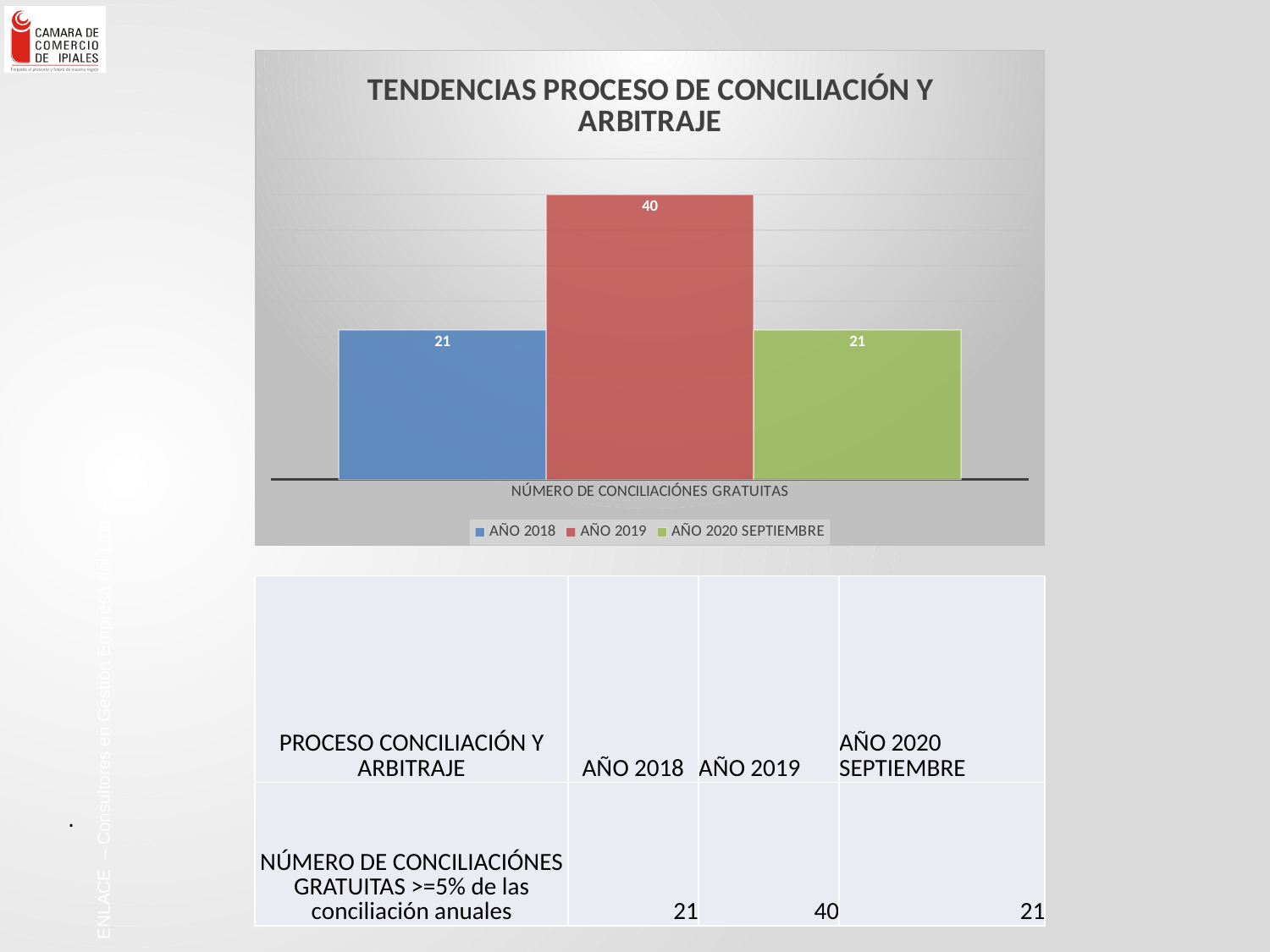
Which is larger, the value for AÑO 2019 or the value for AÑO 2020 SEPTIEMBRE? AÑO 2019 What is the title of the chart? TENDENCIAS PROCESO DE CONCILIACIÓN Y ARBITRAJE What is the category label shown on the x axis of the chart? NÚMERO DE CONCILIACIÓNES GRATUITAS Do the values for AÑO 2018 and AÑO 2020 SEPTIEMBRE differ, or are they equal? Equal How many series does the legend list? 3 What kind of chart is shown on the slide? Bar chart What is the value for AÑO 2020 SEPTIEMBRE in the chart? 21 What is the total of the three values shown in the chart? 82 Which series has the highest value in the chart? AÑO 2019 What is the value for AÑO 2018 in the chart? 21 What is the difference between the values for AÑO 2019 and AÑO 2018? 19 What is the value for AÑO 2019 in the chart? 40